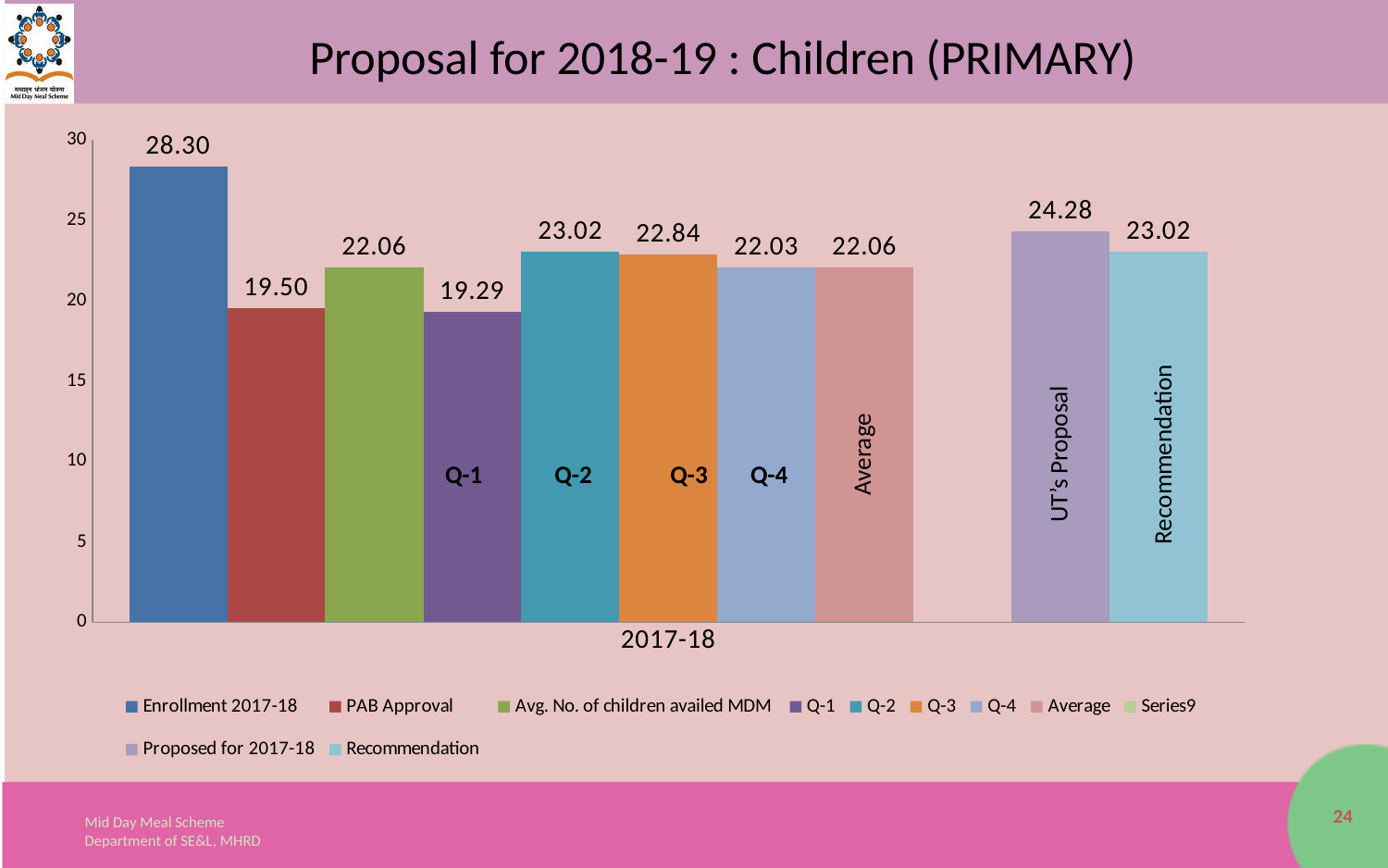
What is the value of the UT's Proposal bar? 24.28 What is the difference between the Enrollment 2017-18 value and the PAB Approval value? 8.80 What is the value of the Recommendation bar? 23.02 What is the title of the slide's chart? Proposal for 2018-19 : Children (PRIMARY) What is the value of the PAB Approval bar? 19.50 Which bar has the lowest value? Q-1 What is the value shown for Q-3? 22.84 What kind of chart is shown on the slide? Bar chart What is the value of the Enrollment 2017-18 bar? 28.30 Which bar has the highest value? Enrollment 2017-18 What is the difference between the UT's Proposal value and the Recommendation value? 1.26 Which is larger, the Q-2 value or the Q-4 value? Q-2